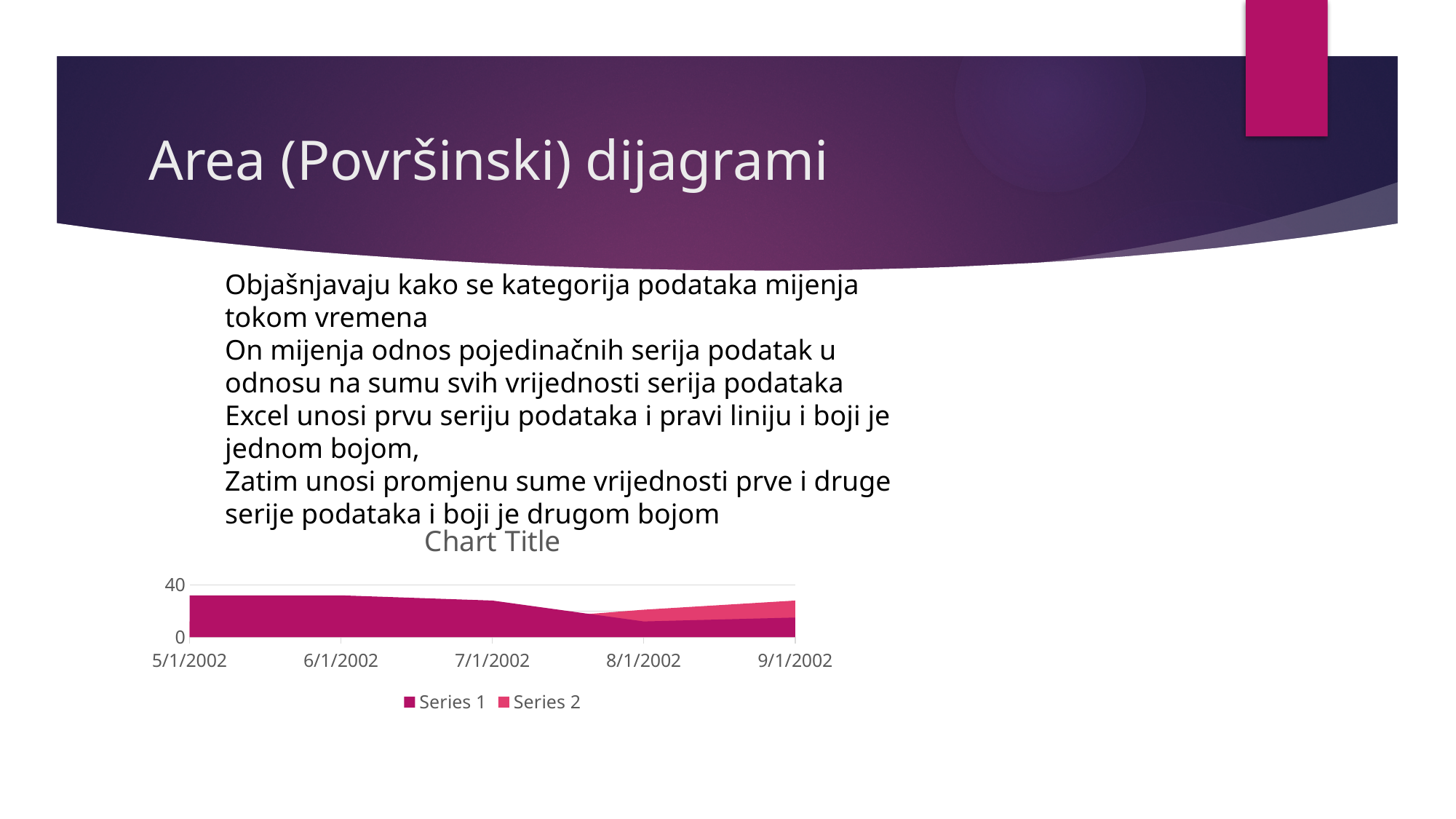
How many dates are shown along the x axis of the chart? 5 Is the value of Series 1 at 5/1/2002 greater or less than 40? less How many series does the chart legend list? 2 What is the title of the chart? Chart Title What kind of chart is shown on the slide? Area chart What is the highest value shown on the y axis of the chart? 40 Does Series 1 rise or fall from 5/1/2002 to 8/1/2002? fall At which date is Series 1 at its lowest? 8/1/2002 What are the names of the series listed in the chart legend? Series 1 and Series 2 Which is larger for Series 1: the value at 5/1/2002 or the value at 8/1/2002? 5/1/2002